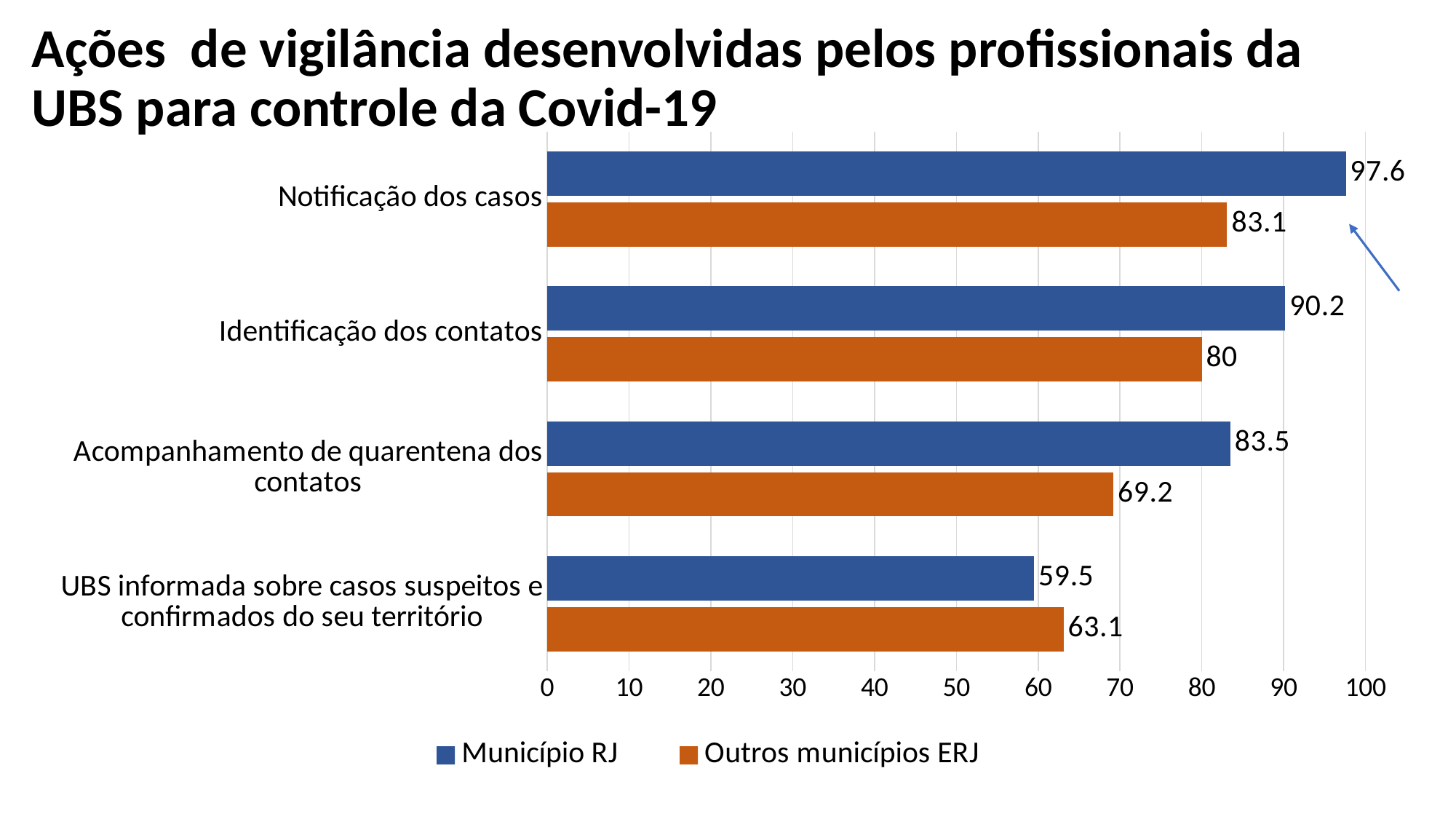
What is the value for Outros municípios ERJ for Acompanhamento de quarentena dos contatos? 69.2 What is the value for Município RJ for Notificação dos casos? 97.6 What is the value for Município RJ for UBS informada sobre casos suspeitos e confirmados do seu território? 59.5 How many series does the legend list? 2 How many categories are shown on the chart? 4 Which colour represents Outros municípios ERJ in the chart? Orange What is the difference between Município RJ and Outros municípios ERJ for Notificação dos casos? 14.5 What is the value for Outros municípios ERJ for Identificação dos contatos? 80 Which category has the highest value for Município RJ? Notificação dos casos Which is larger for UBS informada sobre casos suspeitos e confirmados do seu território: Município RJ or Outros municípios ERJ? Outros municípios ERJ Which category has the lowest value for Outros municípios ERJ? UBS informada sobre casos suspeitos e confirmados do seu território What kind of chart is shown on the slide? Bar chart